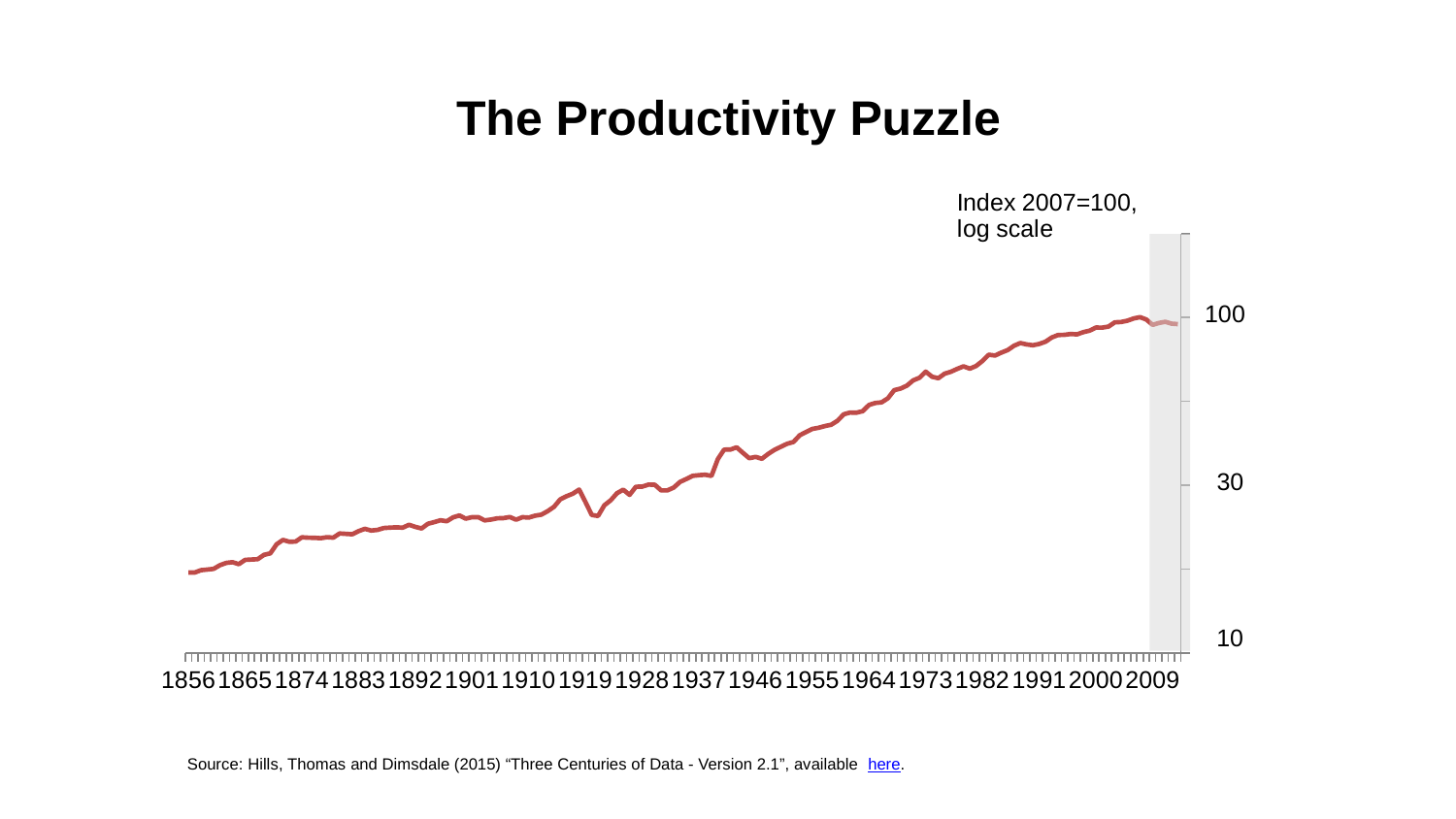
Is the value for 1973 greater or less than 30? greater Overall, does the plotted line rise or fall from 1856 to 2009? rise Is the value for 1892 greater or less than 10? greater How many lines are plotted on the chart? 1 What does the note above the y axis say about the index and scale? Index 2007=100, log scale Is the value for 1856 greater or less than 30? less Which year has the lowest value on the line, 1856 or 2009? 1856 What is the title of the slide? The Productivity Puzzle How many year labels are shown on the x axis? 18 What type of chart is shown on the slide? line chart Which year has the larger value, 1901 or 1955? 1955